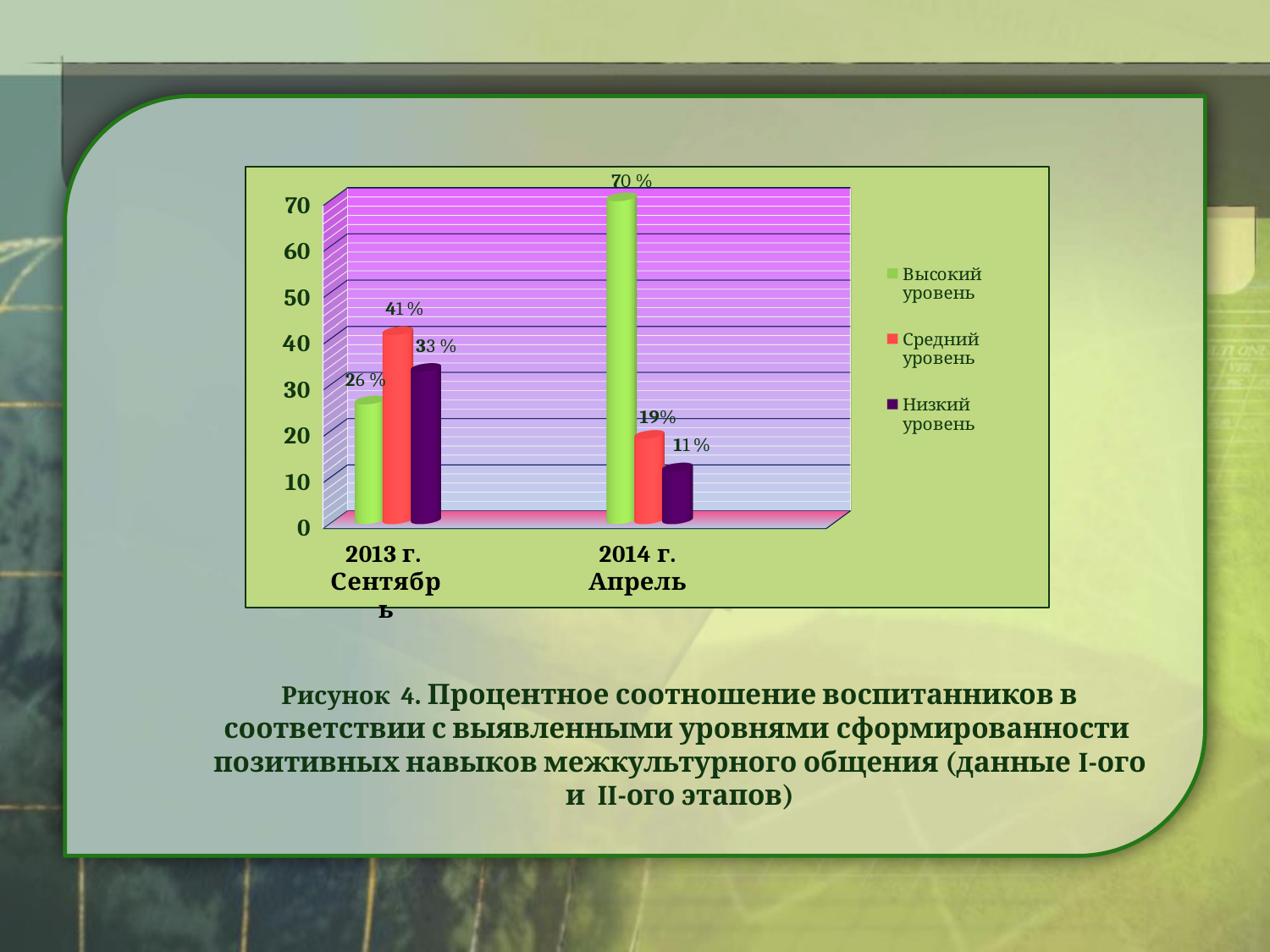
How many categories are shown on the x axis? 2 Which series has the lowest value in 2014 г. Апрель? Низкий уровень Does the value for Средний уровень rise or fall from 2013 г. Сентябрь to 2014 г. Апрель? Fall What is the value for Низкий уровень in 2014 г. Апрель? 11 % Which is larger: Низкий уровень in 2013 г. Сентябрь or Средний уровень in 2014 г. Апрель? Низкий уровень in 2013 г. Сентябрь How many series does the legend list? 3 What is the difference between the Высокий уровень values for 2014 г. Апрель and 2013 г. Сентябрь? 44 % What is the value for Средний уровень in 2013 г. Сентябрь? 41 % What is the value for Высокий уровень in 2014 г. Апрель? 70 % Which series has the highest value in 2013 г. Сентябрь? Средний уровень What kind of chart is shown on the slide? Bar chart What is the value for Высокий уровень in 2013 г. Сентябрь? 26 %